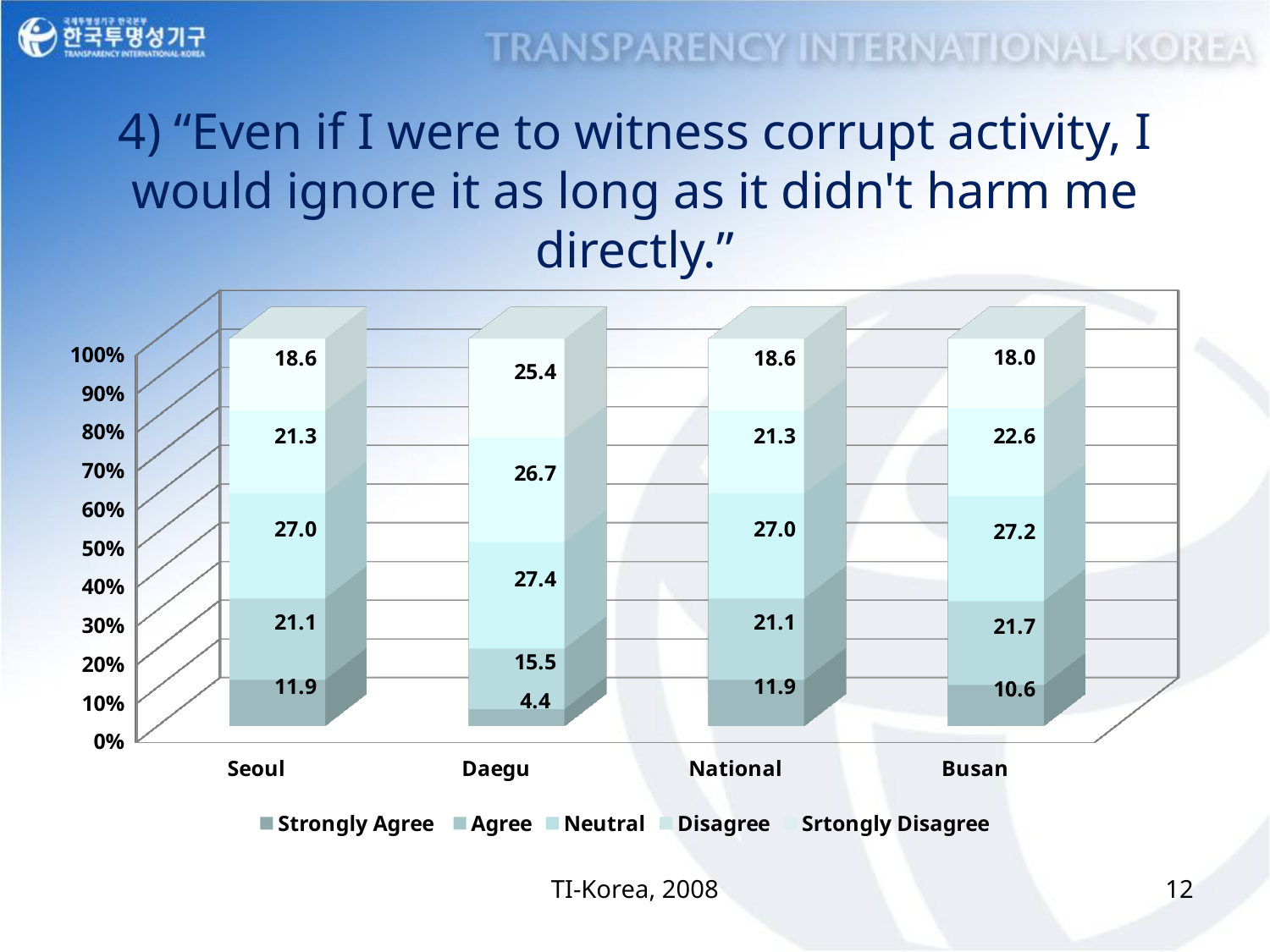
How many categories are shown on the x axis? 4 Which has the larger Disagree value, Busan or Seoul? Busan What is the difference between the Agree values for Seoul and Daegu? 5.6 What is the Strongly Disagree value for Daegu? 25.4 What is the difference between the Strongly Agree values for Seoul and Busan? 1.3 What is the Neutral value for Busan? 27.2 What is the value for Strongly Agree in Daegu? 4.4 Which category has the highest Strongly Disagree value? Daegu Which category has the lowest Strongly Agree value? Daegu What is the Agree value for National? 21.1 How many series does the legend list? 5 What kind of chart is shown on the slide? Stacked bar chart